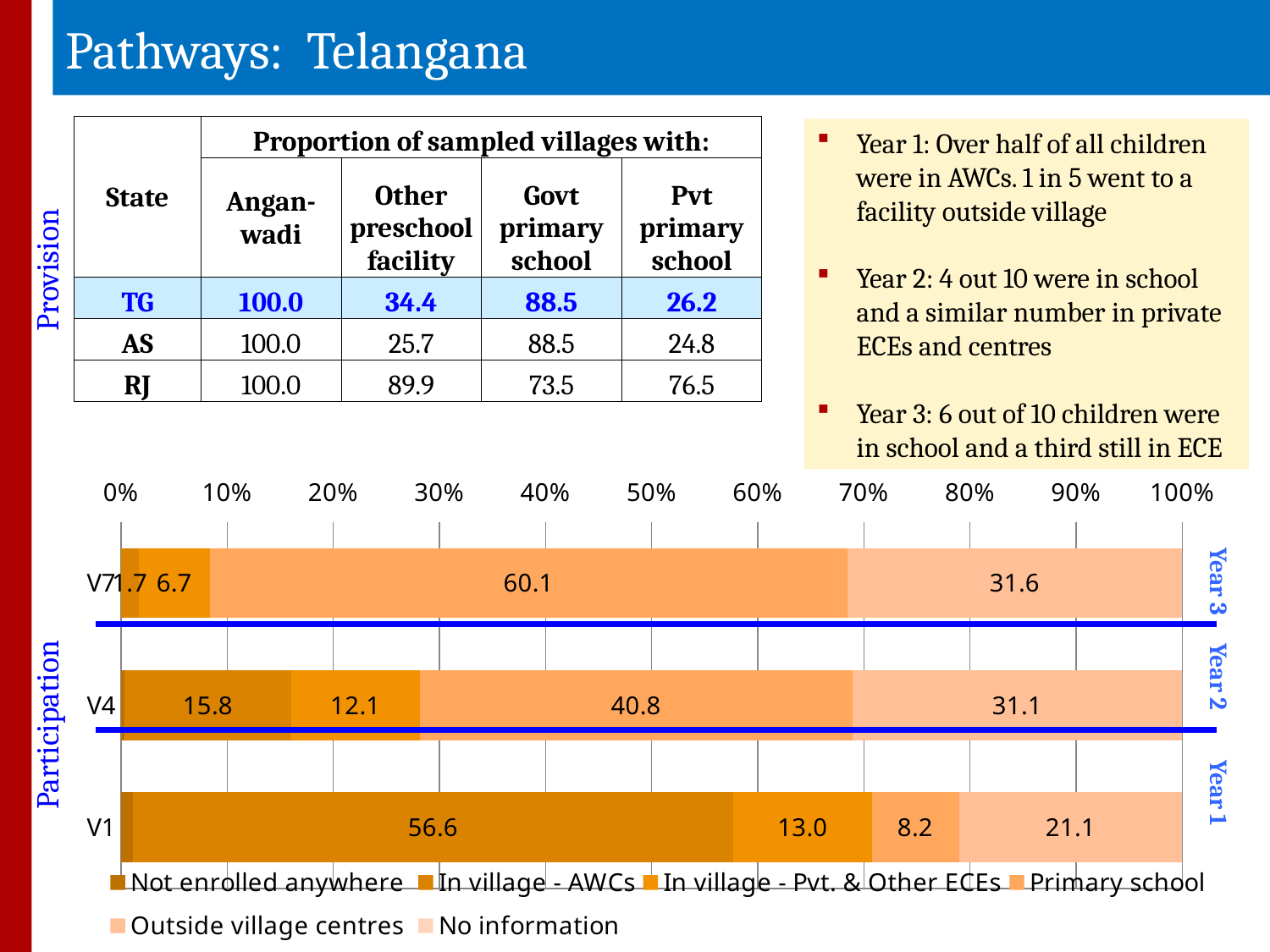
In the Participation chart, what is the Primary school value for V7? 60.1 In the Participation chart, what is the value of the largest segment in the V1 bar? 56.6 What type of chart is shown in the Participation section of the slide? Stacked bar chart In the Participation chart, what is the difference between the In village - AWCs values for V1 and V4? 40.8 In the Participation chart, what is the Primary school value for V4? 40.8 In the Participation chart, which year label is shown next to the V1 bar? Year 1 How many bars (categories) are plotted in the Participation chart? 3 What is the maximum value shown on the horizontal axis of the Participation chart? 100% In the Participation chart, what is the Outside village centres value for V1? 21.1 In the Participation chart, which bar has the larger Primary school segment, V7 or V4? V7 In the Participation chart, what is the difference between the Primary school values for V7 and V4? 19.3 How many series does the legend of the Participation chart list? 6